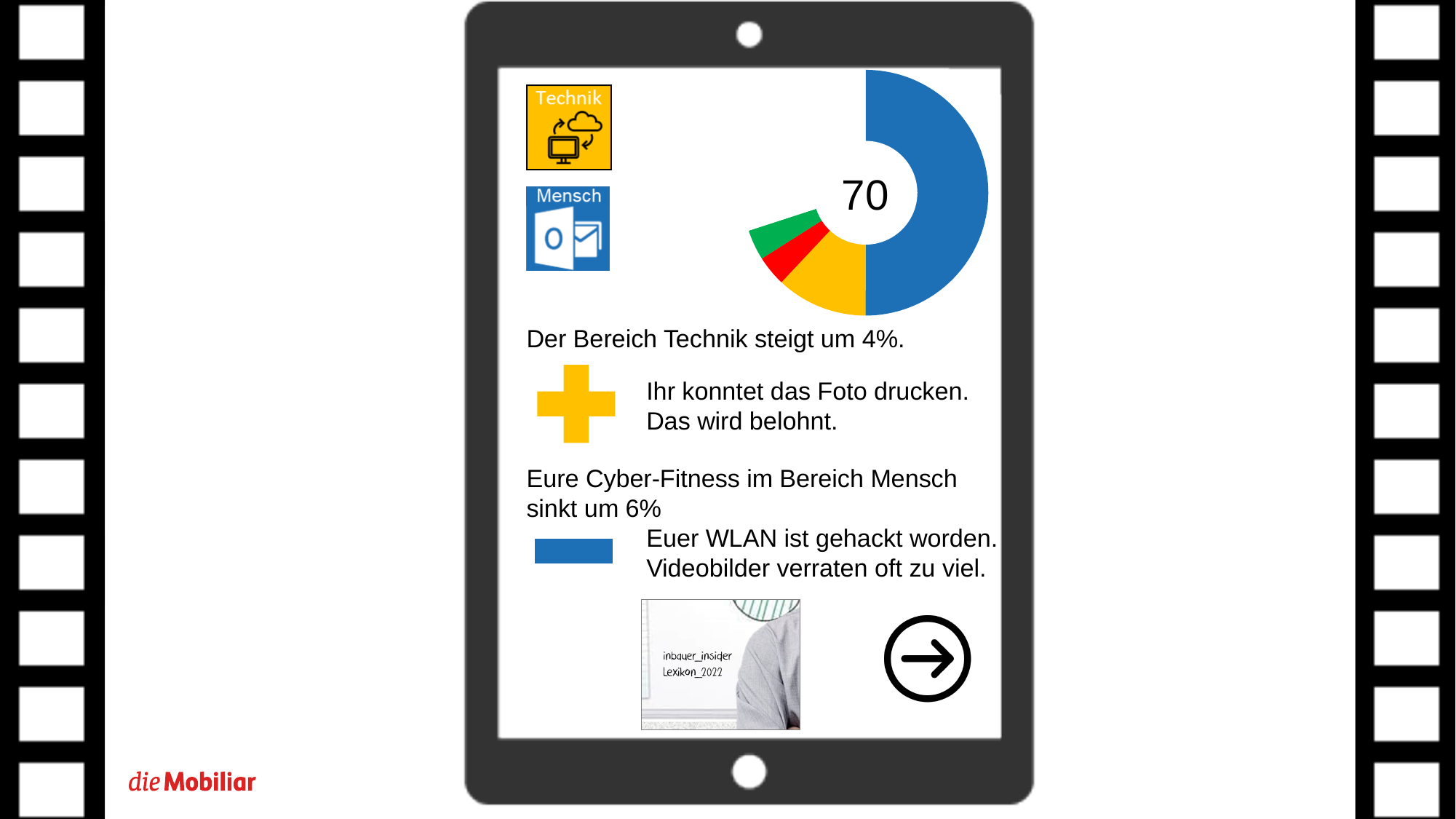
Is the blue segment of the doughnut chart larger or smaller than the yellow segment? larger Which colour is the segment that sits between the yellow and green segments of the doughnut chart? red What kind of chart is shown on the tablet screen? doughnut chart Is the yellow segment of the doughnut chart larger or smaller than the green segment? larger Which colour segment of the doughnut chart is the largest? blue What number is displayed in the centre of the doughnut chart? 70 How many coloured segments does the doughnut chart have? 4 Does the doughnut chart have a legend? No